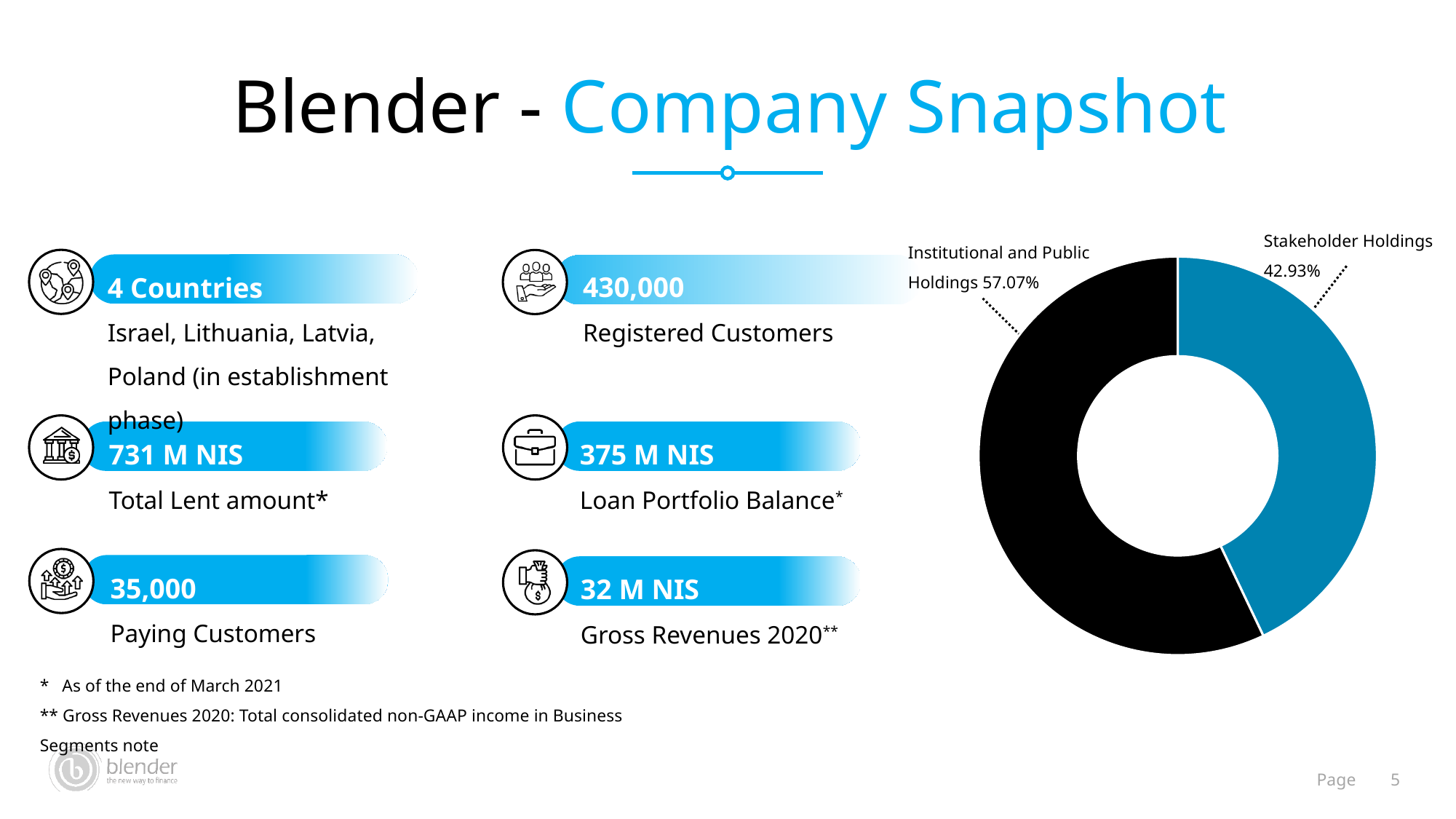
What colour is the Institutional and Public Holdings slice in the donut chart? Black Which is larger in the donut chart: Institutional and Public Holdings or Stakeholder Holdings? Institutional and Public Holdings What share of holdings is labelled as Stakeholder Holdings in the donut chart? 42.93% What is the total of the two slices shown in the donut chart? 100% Which slice of the donut chart is the largest? Institutional and Public Holdings Which slice of the donut chart is the smallest? Stakeholder Holdings How many slices does the donut chart have? 2 What share of holdings is labelled as Institutional and Public Holdings in the donut chart? 57.07% What colour is the Stakeholder Holdings slice in the donut chart? Blue What is the difference in percentage points between Institutional and Public Holdings and Stakeholder Holdings in the donut chart? 14.14 What kind of chart is shown on the right of the slide? Donut chart Is the Stakeholder Holdings share in the donut chart greater or less than 50%? less